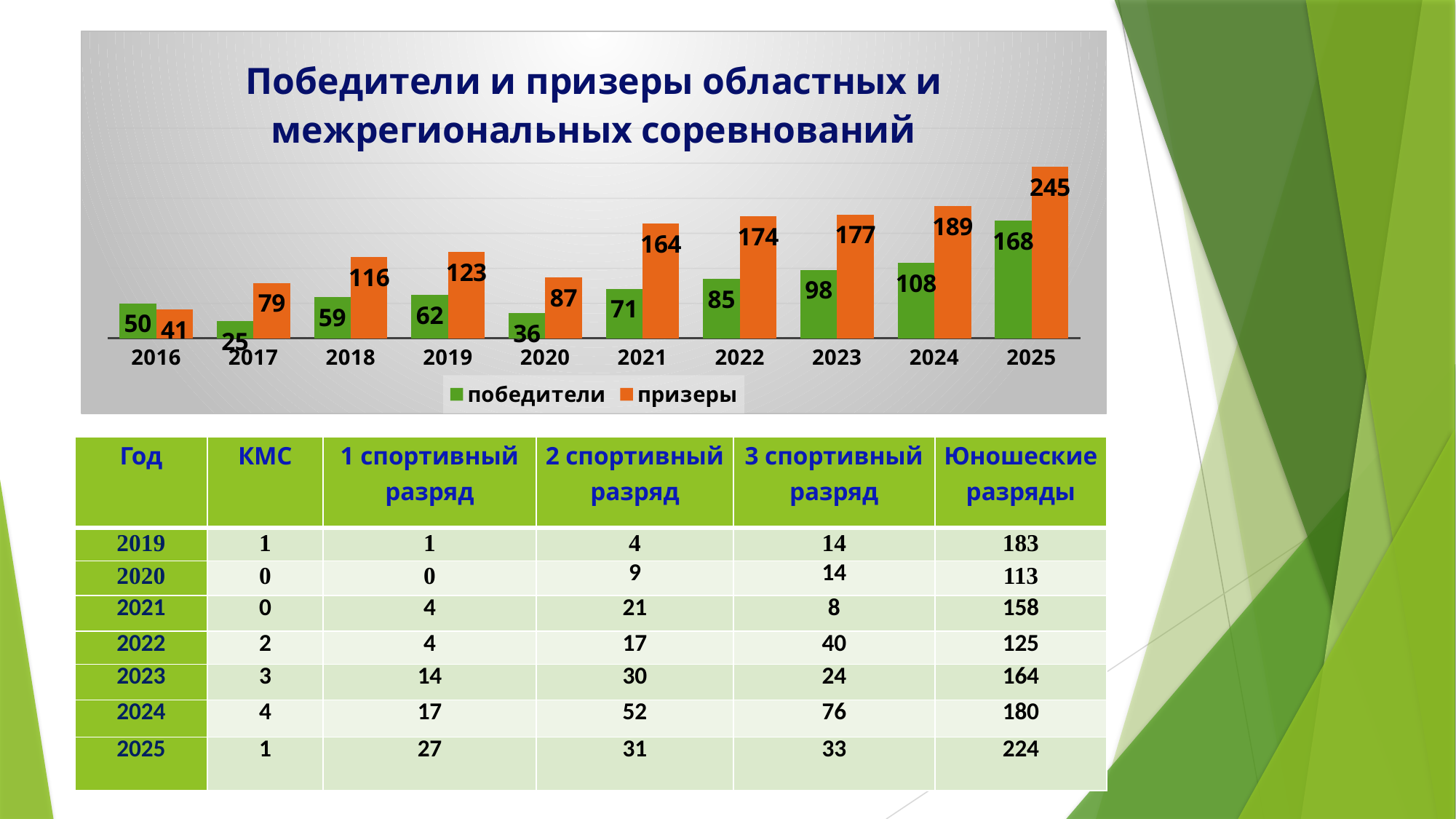
How many series does the chart legend list? 2 What is the value for призеры in 2019? 123 Which year has the highest value for призеры? 2025 Do the values for призеры rise or fall from 2020 to 2025? rise What is the difference between призеры and победители in 2024? 81 What is the value for победители in 2021? 71 What kind of chart is shown on the slide? bar chart What colour are the bars for призеры in the chart? orange How many years are shown on the x axis of the chart? 10 What is the value for победители in 2025? 168 In 2016, which is larger: победители or призеры? победители Which year has the lowest value for победители? 2017